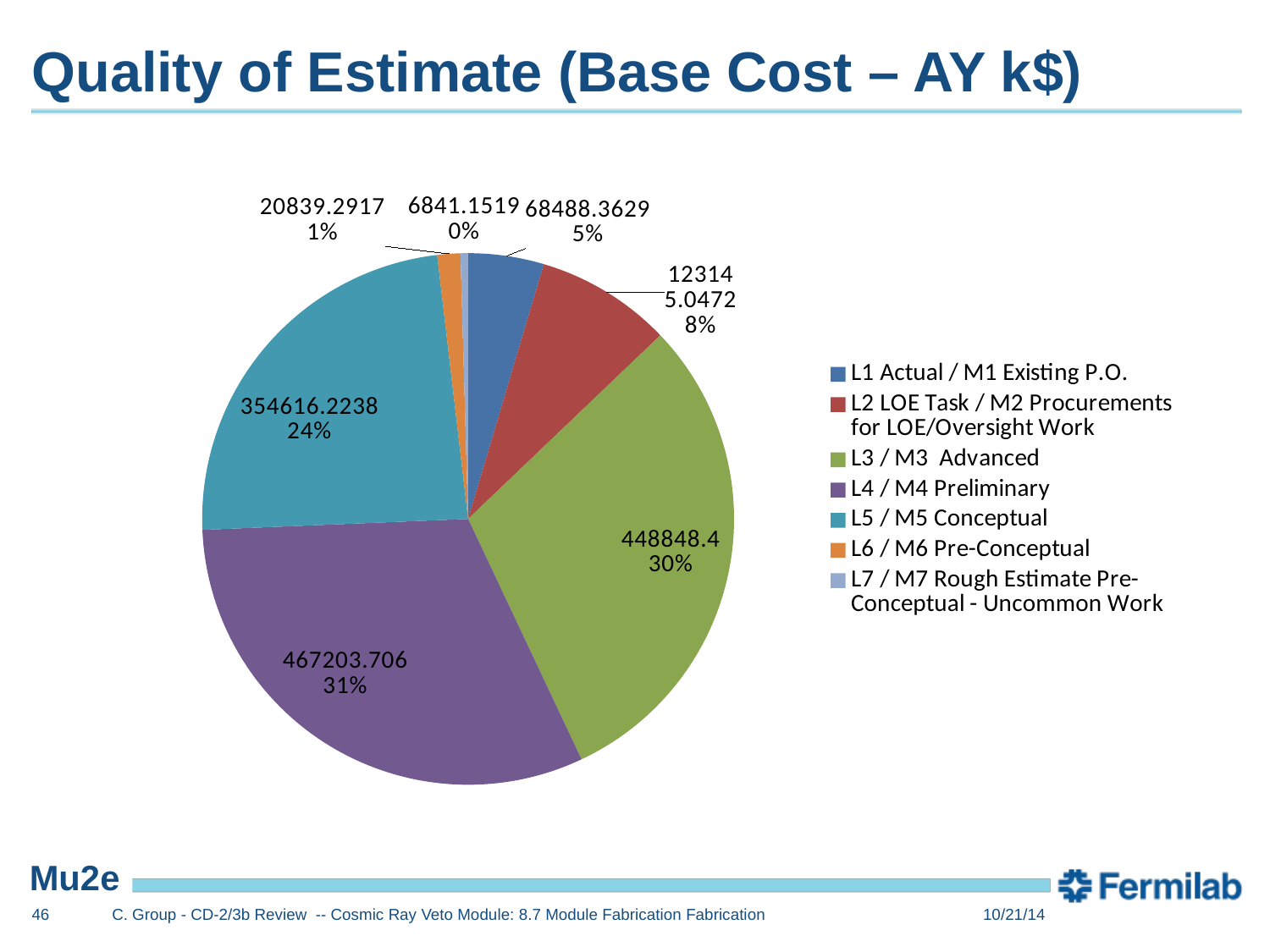
Which category has the smallest slice of the pie? L7 / M7 Rough Estimate Pre-Conceptual - Uncommon Work What is the value shown for L1 Actual / M1 Existing P.O.? 68488.3629 What percentage share of the pie does L5 / M5 Conceptual have? 24% Which category has the largest slice of the pie? L4 / M4 Preliminary How many slices does the pie chart have? 7 How many entries does the legend list? 7 What kind of chart is shown on the slide? pie chart What percentage share of the pie does L2 LOE Task / M2 Procurements for LOE/Oversight Work have? 8% What is the value shown for L5 / M5 Conceptual? 354616.2238 What is the value shown for L3 / M3 Advanced? 448848.4 What is the title of the slide containing the pie chart? Quality of Estimate (Base Cost – AY k$) What is the value shown for L4 / M4 Preliminary? 467203.706